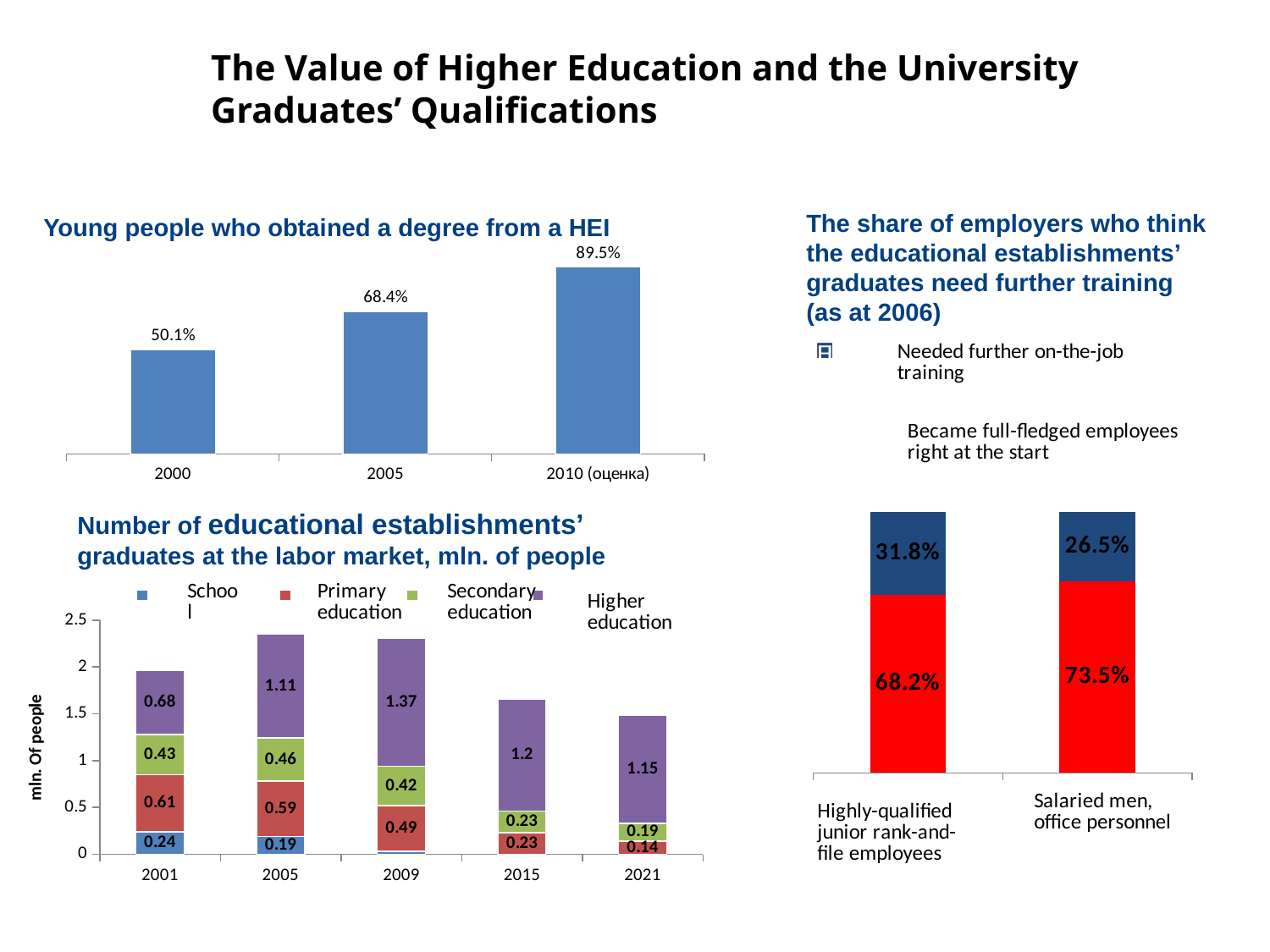
In the chart 'Young people who obtained a degree from a HEI', what is the value for 2005? 68.4% In the chart on the share of employers who think graduates need further training, what is the difference between the 'became full-fledged employees right at the start' shares for the two employee groups? 5.3% In the chart on the share of employers who think graduates need further training, what share of employers of salaried men, office personnel said they needed further on-the-job training? 73.5% In the chart 'Young people who obtained a degree from a HEI', which year has the highest value? 2010 (оценка) In the chart 'Number of educational establishments' graduates at the labor market', how many series does the legend list? 4 In the chart 'Young people who obtained a degree from a HEI', what is the difference between the 2010 (оценка) value and the 2000 value? 39.4% In the chart 'Number of educational establishments' graduates at the labor market', which is larger: the Primary education value for 2001 or for 2021? 2001 In the chart 'Number of educational establishments' graduates at the labor market', what is the School value for 2001? 0.24 In the chart 'Number of educational establishments' graduates at the labor market', how many years are shown on the x axis? 5 In the chart 'Number of educational establishments' graduates at the labor market', what is the Higher education value for 2009? 1.37 In the chart 'Number of educational establishments' graduates at the labor market', what is the total of the stacked bar for 2005? 2.35 In the chart 'Young people who obtained a degree from a HEI', do the values rise or fall from 2000 to 2010? rise